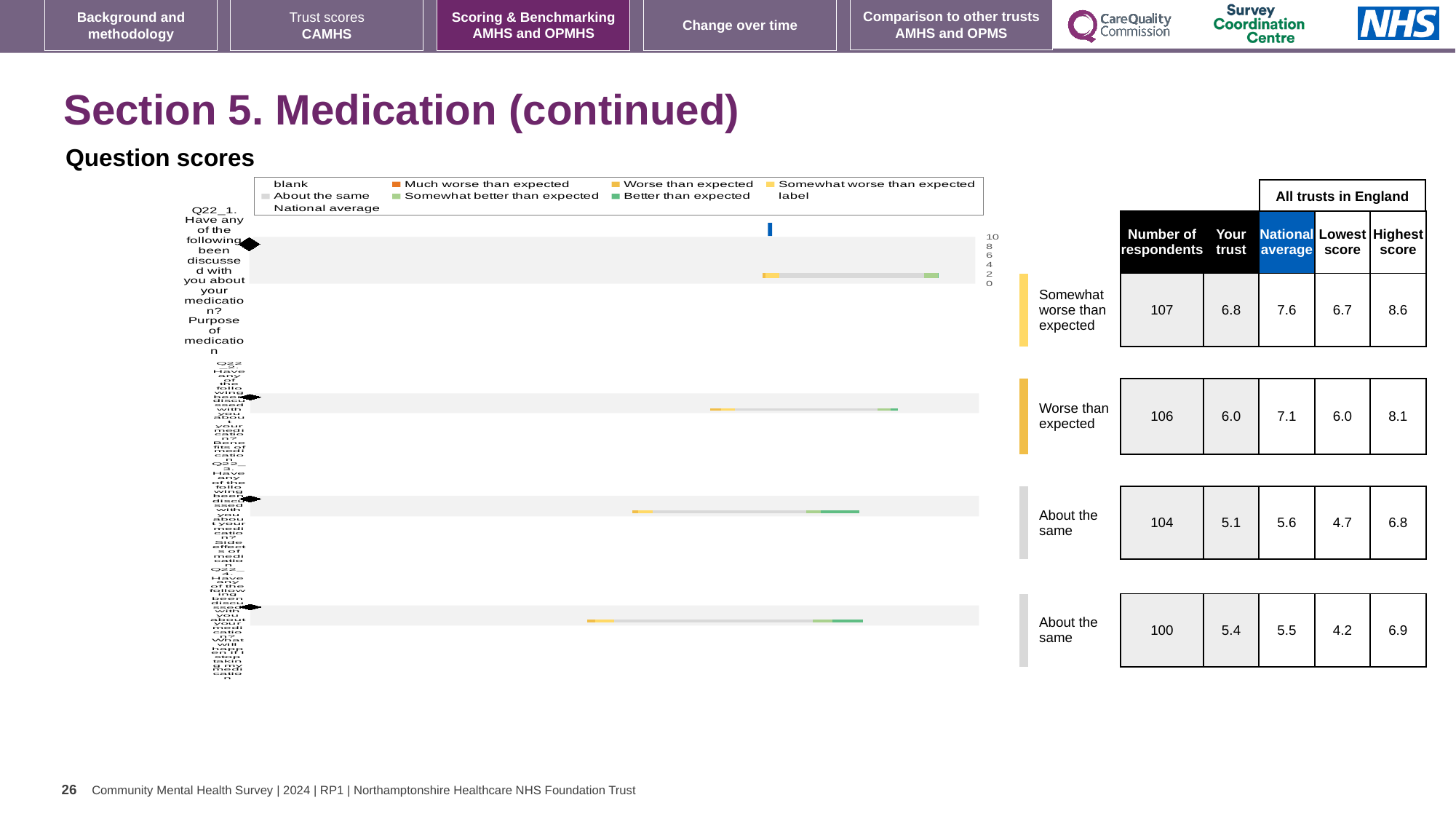
What type of chart is used to show the question scores on this slide? bar chart What colour is used in the chart legend for 'Better than expected'? Green In the table beside the chart, what is the national average for the second question (Q22_2, benefits of medication)? 7.1 In the table beside the chart, what is the 'Your trust' score for the first question (Q22_1, purpose of medication)? 6.8 Which question has the highest 'Your trust' score in the table beside the chart? Q22_1 (purpose of medication) In the table beside the chart, what is the highest score among all trusts in England for the third question (Q22_3, side effects of medication)? 6.8 In the table beside the chart, how many respondents answered the fourth question (Q22_4)? 100 For the second question (Q22_2), which is larger: the 'Your trust' score or the national average? National average What benchmark category is shown for the first question (Q22_1) next to the chart? Somewhat worse than expected What is the difference between the national average and the 'Your trust' score for the first question (Q22_1)? 0.8 How many questions (bars) are plotted in the question scores chart? 4 Which question has the lowest number of respondents in the table beside the chart? Q22_4 (what will happen if I stop taking my medication)